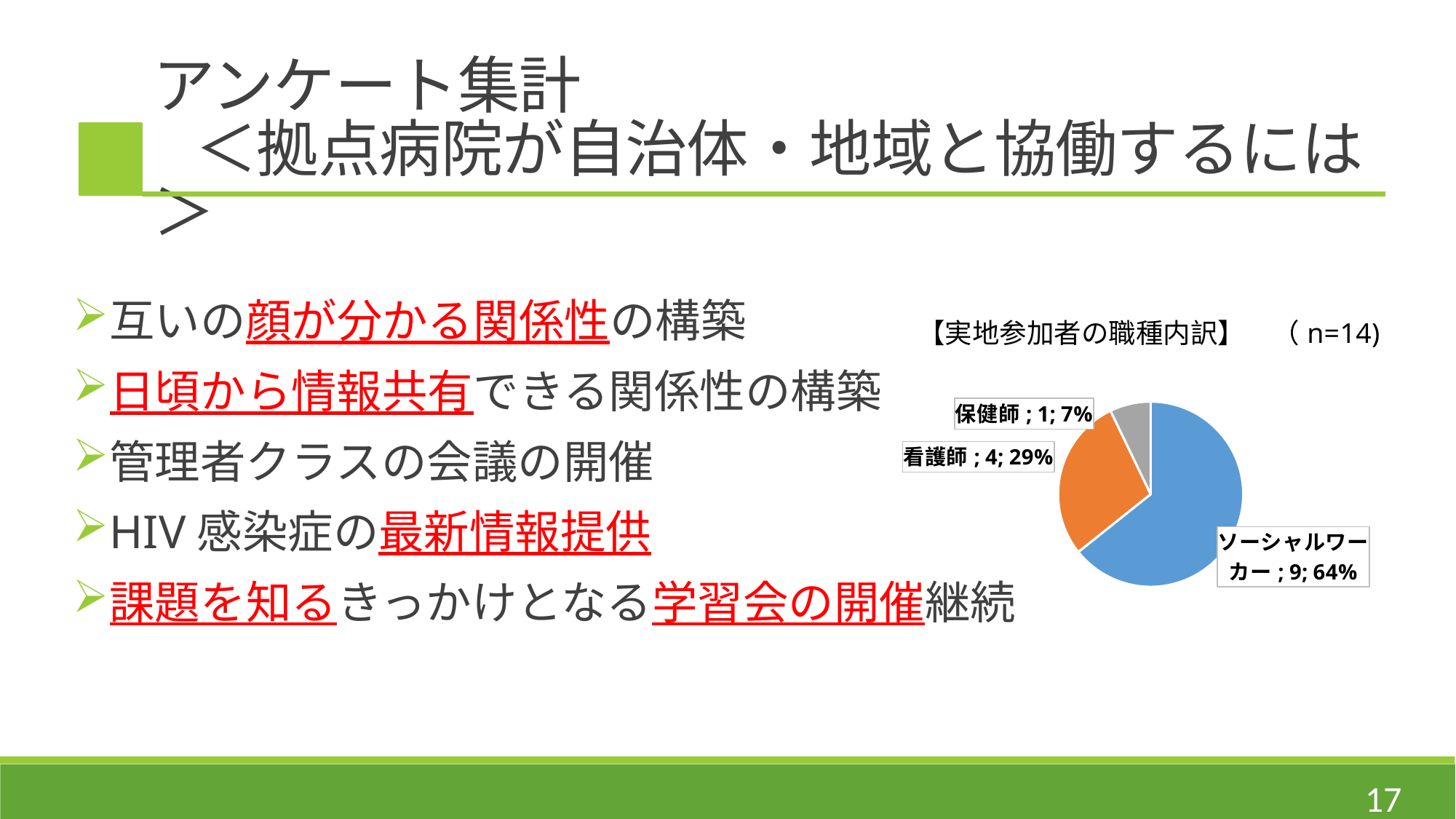
What is the count for 看護師 in the pie chart? 4 How many slices does the pie chart have? 3 Which category has the smallest slice in the pie chart? 保健師 Which category has the largest slice in the pie chart? ソーシャルワーカー What is the difference in count between ソーシャルワーカー and 看護師? 5 What is the count for 保健師 in the pie chart? 1 What share of the pie does ソーシャルワーカー represent? 64% What is the count for ソーシャルワーカー in the pie chart? 9 What share of the pie does 看護師 represent? 29% Which is larger, the count for 看護師 or the count for 保健師? 看護師 What is the title of the pie chart? 【実地参加者の職種内訳】 What kind of chart is shown on the slide? pie chart